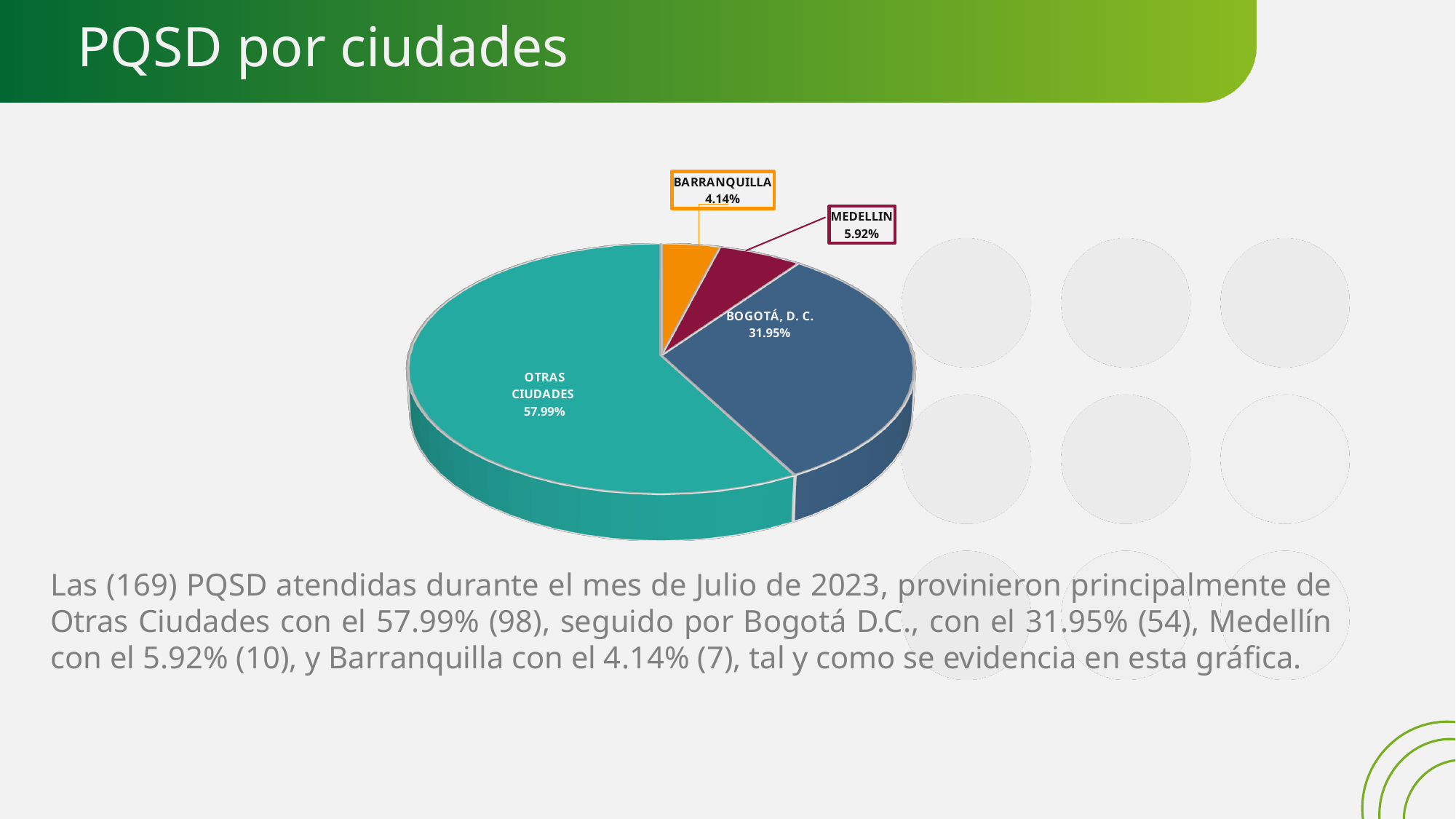
What type of chart is shown on the slide? Pie chart What share of the pie does OTRAS CIUDADES represent? 57.99% What is the value shown for MEDELLIN? 5.92% What is the difference in percentage points between OTRAS CIUDADES and BOGOTÁ, D. C.? 26.04 How many categories are shown in the pie chart? 4 What is the difference in percentage points between MEDELLIN and BARRANQUILLA? 1.78 Which category has the smallest slice of the pie? BARRANQUILLA What is the title of the slide containing the chart? PQSD por ciudades What is the value shown for BARRANQUILLA? 4.14% Which is larger, the slice for MEDELLIN or the slice for BARRANQUILLA? MEDELLIN Which category has the largest slice of the pie? OTRAS CIUDADES What share of the pie does BOGOTÁ, D. C. represent? 31.95%